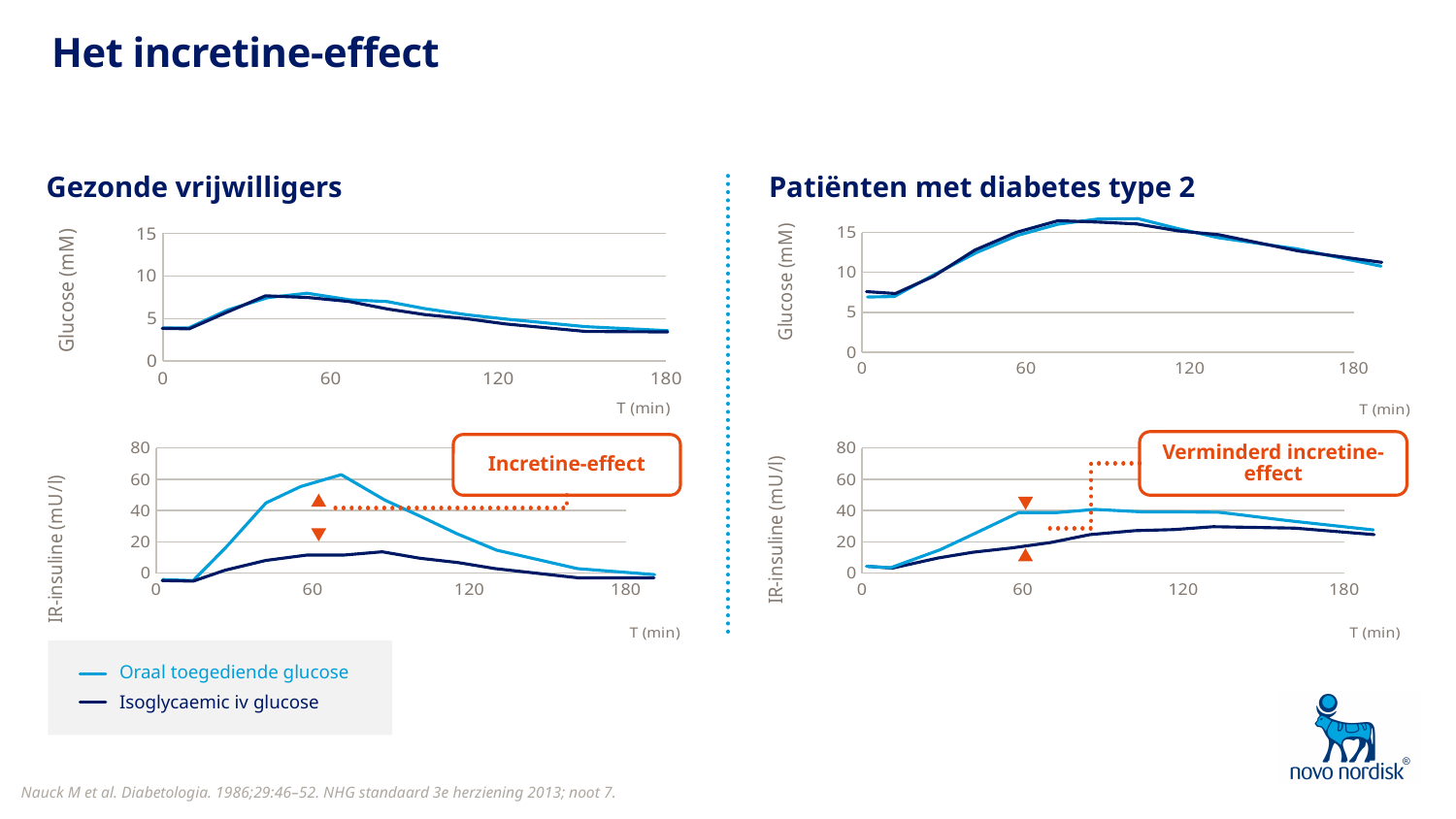
How many series does the legend at the bottom left of the slide list? 2 What is the label on the x axis of the charts on this slide? T (min) In the 'Glucose (mM)' chart under 'Patiënten met diabetes type 2', is the glucose value at 0 minutes greater or less than 5? greater In the 'IR-insuline (mU/l)' chart under 'Gezonde vrijwilligers', is the peak value of the 'Isoglycaemic iv glucose' line greater or less than 20? less In the 'IR-insuline (mU/l)' chart under 'Patiënten met diabetes type 2', is the peak value of the 'Isoglycaemic iv glucose' line greater or less than 40? less In the 'IR-insuline (mU/l)' chart under 'Gezonde vrijwilligers', do the 'Oraal toegediende glucose' values rise or fall between 0 and 60 minutes? rise In the 'Glucose (mM)' chart under 'Gezonde vrijwilligers', do the glucose values rise or fall between 60 and 180 minutes? fall In the 'IR-insuline (mU/l)' chart under 'Gezonde vrijwilligers', which series has the higher value at 60 minutes: 'Oraal toegediende glucose' or 'Isoglycaemic iv glucose'? Oraal toegediende glucose What text is in the orange box on the 'IR-insuline (mU/l)' chart under 'Patiënten met diabetes type 2'? Verminderd incretine-effect What kind of chart is the 'Glucose (mM)' chart under 'Gezonde vrijwilligers'? line chart